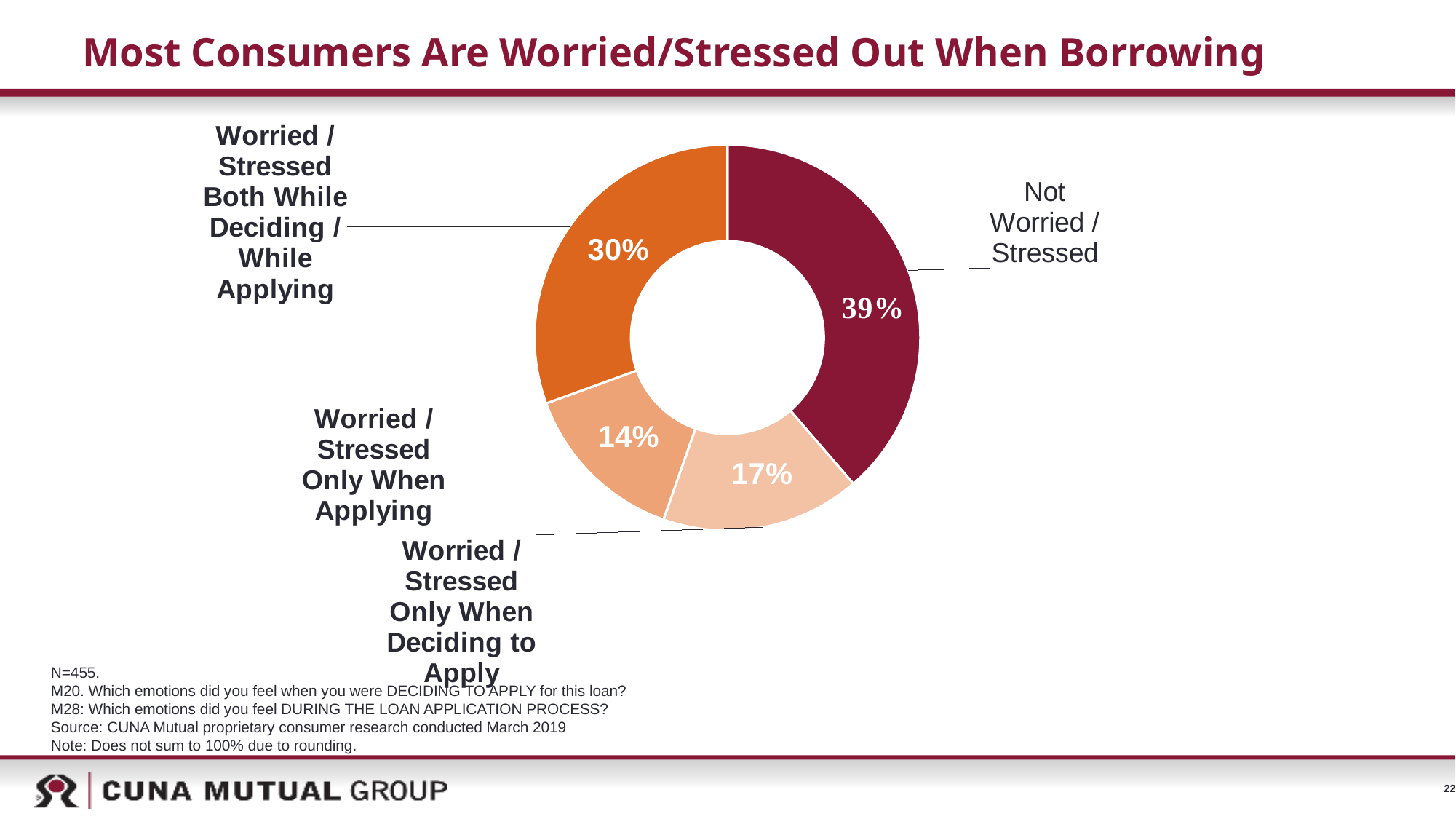
What is the title of the slide? Most Consumers Are Worried/Stressed Out When Borrowing What is the sample size (N) noted on the slide? N=455 What share of consumers were Worried / Stressed Only When Deciding to Apply? 17% Which is larger: Worried / Stressed Only When Deciding to Apply or Worried / Stressed Only When Applying? Worried / Stressed Only When Deciding to Apply Which category has the largest slice of the pie? Not Worried / Stressed What kind of chart is shown on the slide? Pie chart (donut) Which category has the smallest slice of the pie? Worried / Stressed Only When Applying What share of consumers were Worried / Stressed Only When Applying? 14% What share of consumers were Worried / Stressed Both While Deciding / While Applying? 30% What share of consumers were Not Worried / Stressed? 39% How many categories are shown in the chart? 4 What is the difference in percentage points between Not Worried / Stressed and Worried / Stressed Both While Deciding / While Applying? 9 percentage points